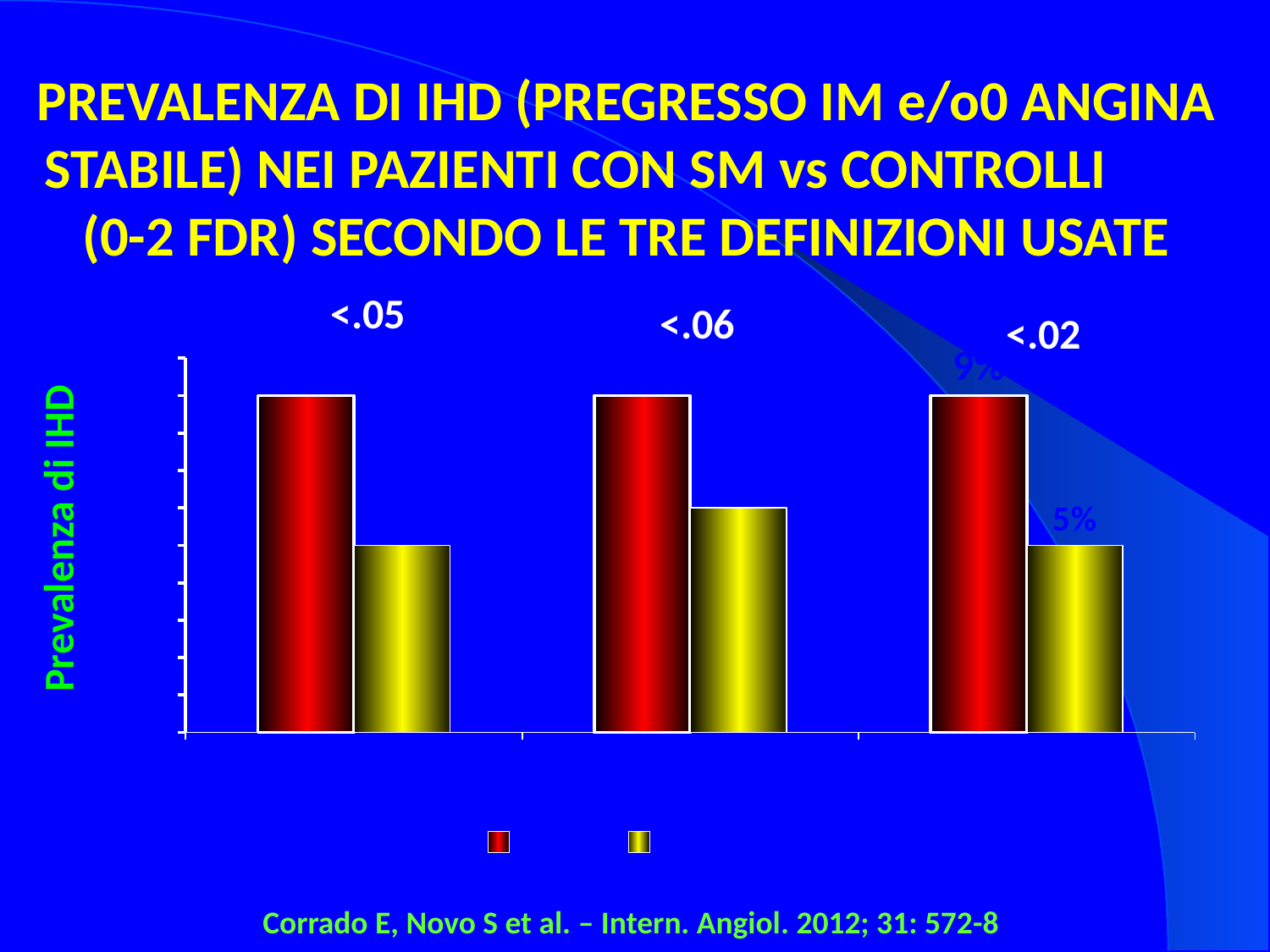
What kind of chart is shown on the slide? bar chart What p-value annotation is printed above the rightmost group of bars? <.02 How many series does the legend below the chart show? 2 What is the label on the vertical axis of the chart? Prevalenza di IHD In the middle group of bars, which bar is taller, the red one or the yellow one? the red one What p-value annotation is printed above the middle group of bars? <.06 How many groups of bars are plotted in the chart? 3 In the third (rightmost) group of bars, which bar is shorter, the red one or the yellow one? the yellow one What p-value annotation is printed above the leftmost group of bars? <.05 Which group has the tallest yellow bar: the first, second or third? the second In the first (leftmost) group of bars, which bar is taller, the red one or the yellow one? the red one